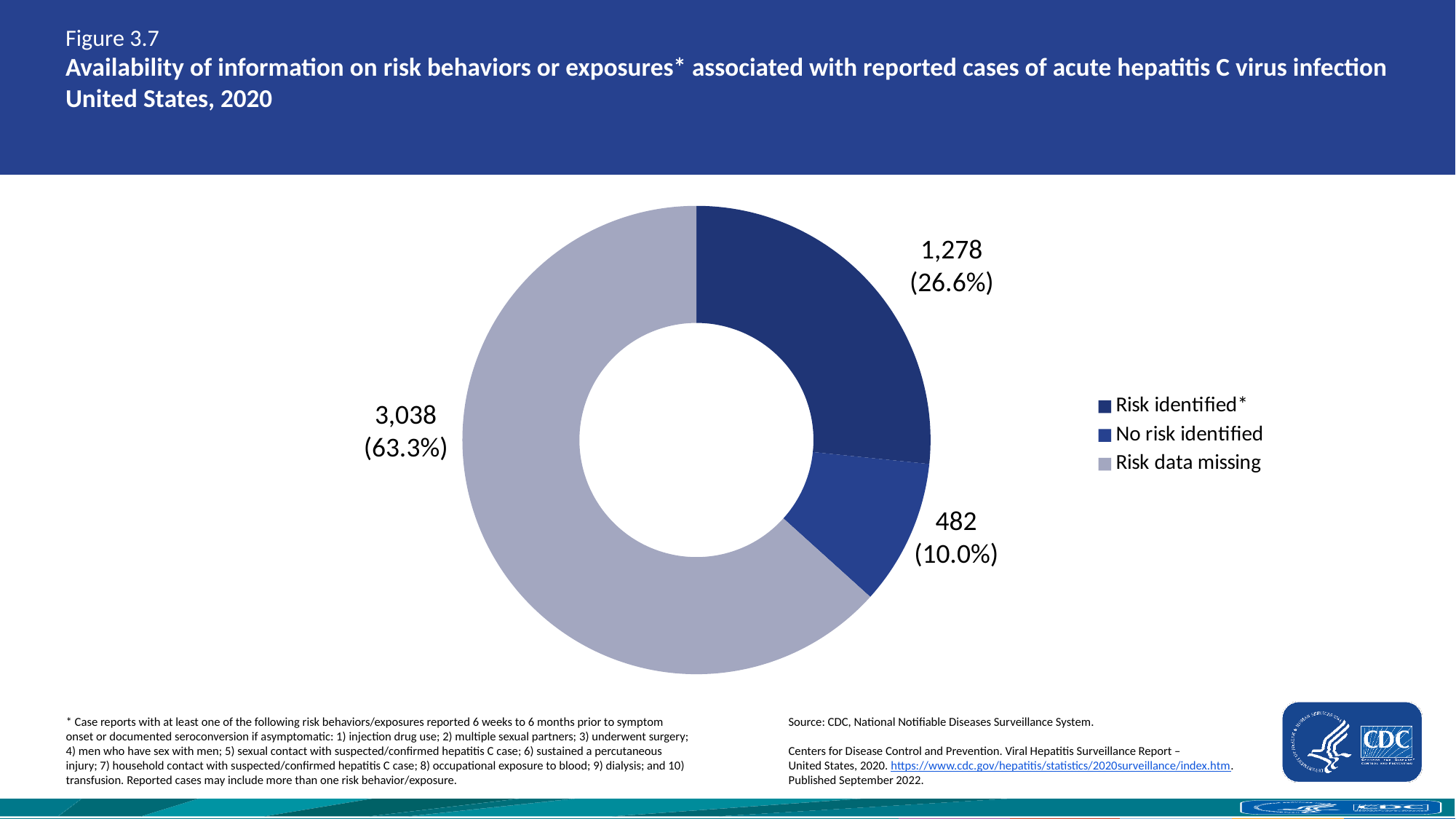
What kind of chart is shown on the slide? Pie chart (doughnut) How many categories does the chart show? 3 Which category is shown in the lightest colour on the chart? Risk data missing What percentage of cases had no risk identified? 10.0% How many cases are in the 'Risk identified' category? 1,278 What is the total number of cases across all three categories? 4,798 What is the difference in cases between 'Risk data missing' and 'Risk identified'? 1,760 What share of cases does the 'Risk identified' slice represent? 26.6% How many cases are in the 'Risk data missing' category? 3,038 Which category has the largest number of cases? Risk data missing Which category has the smallest number of cases? No risk identified Which is larger: the number of cases with risk identified or with no risk identified? Risk identified